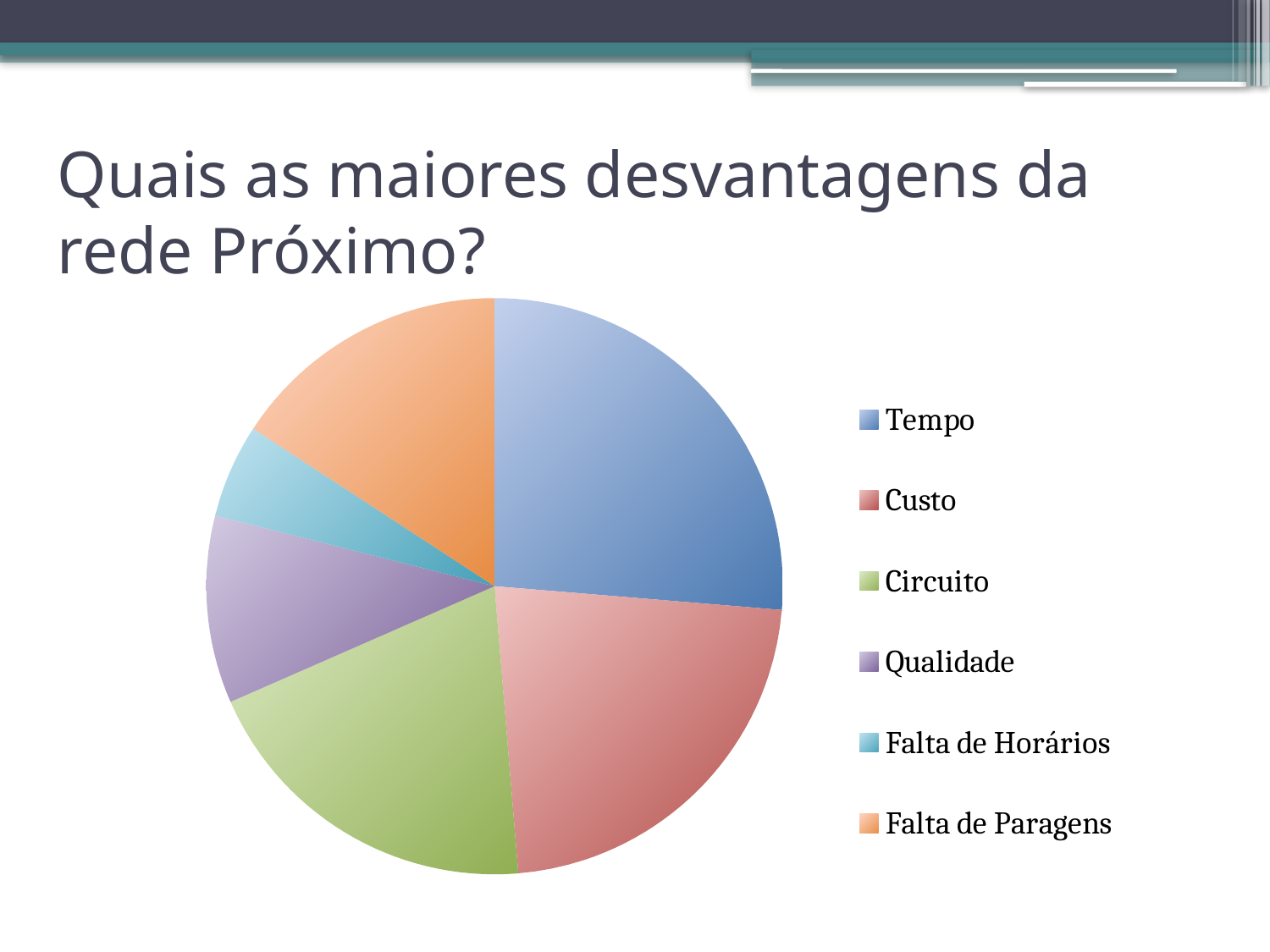
Which slice is larger, Qualidade or Falta de Horários? Qualidade Which slice is larger, Custo or Circuito? Custo What kind of chart is shown on the slide? pie chart How many slices does the pie chart have? 6 Which category is shown in orange in the pie chart? Falta de Paragens Which category has the smallest slice of the pie chart? Falta de Horários Which slice is larger, Falta de Paragens or Falta de Horários? Falta de Paragens Which category has the largest slice of the pie chart? Tempo What is the title of the slide containing the pie chart? Quais as maiores desvantagens da rede Próximo?